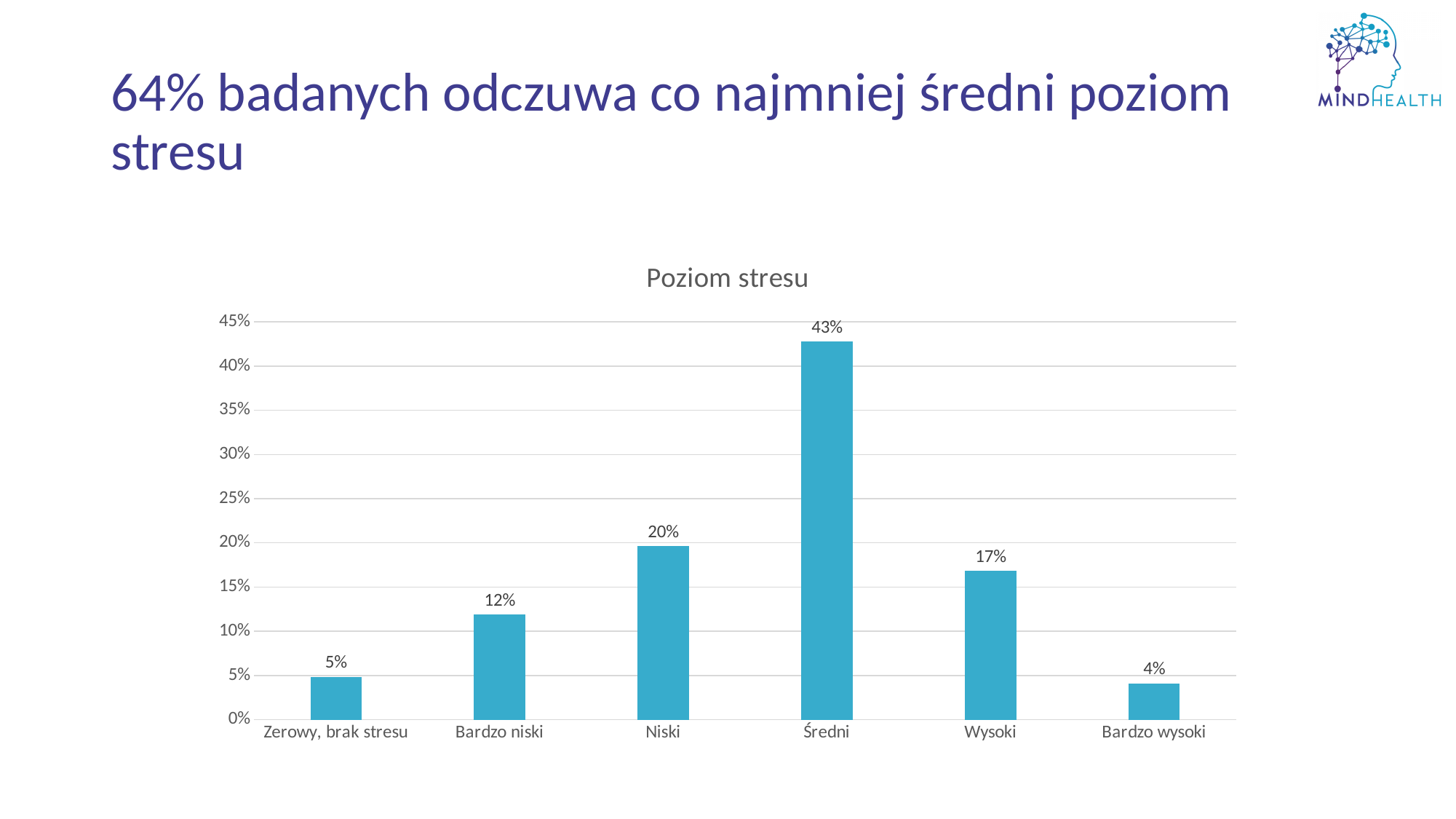
Which category has the lowest value? Bardzo wysoki What is the value for Zerowy, brak stresu? 5% What is the difference between the values for Średni and Niski? 23% Which category has the highest value? Średni What is the value for Bardzo niski? 12% What is the title of the chart? Poziom stresu What is the value for Średni? 43% What is the value for Wysoki? 17% What kind of chart is shown? bar chart Is the value for Wysoki greater or less than 15%? greater Which is larger, the value for Niski or the value for Wysoki? Niski How many categories are shown on the x axis? 6